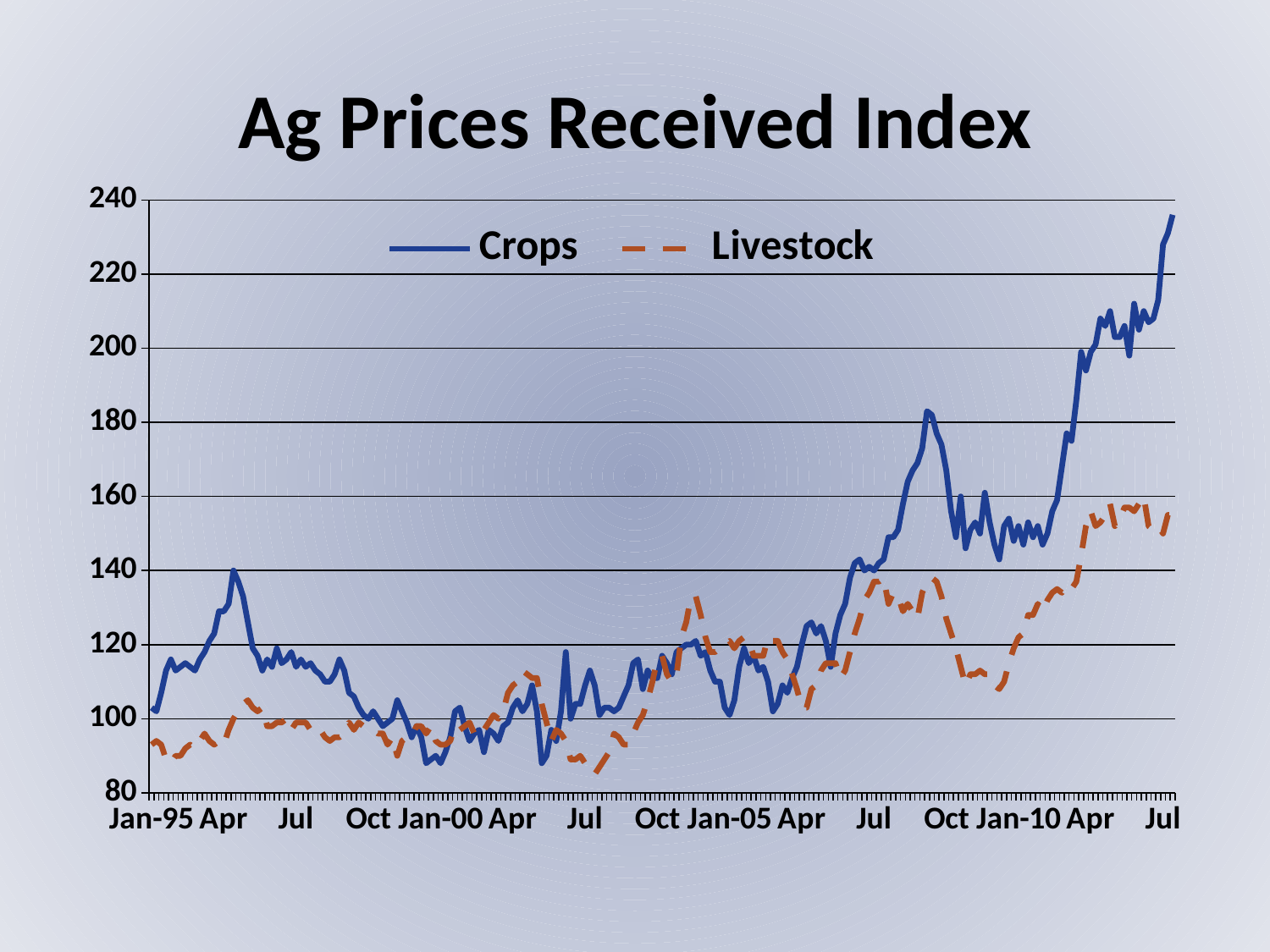
Around Jan-10, which series is higher, Crops or Livestock? Crops How many labels are printed along the horizontal axis? 15 What is the title of the chart? Ag Prices Received Index At the last point on the right (Jul), is the Crops value greater or less than 220? greater At Jan-95, is the Crops value greater or less than 120? less What kind of chart is shown on the slide? line chart How many series does the legend list? 2 At the last point on the right (Jul), which series is higher, Crops or Livestock? Crops Which series is drawn with a dashed line? Livestock At Jan-95, is the Livestock value greater or less than 100? less Does the Crops series rise or fall overall from Jan-10 to the final Jul point? rise